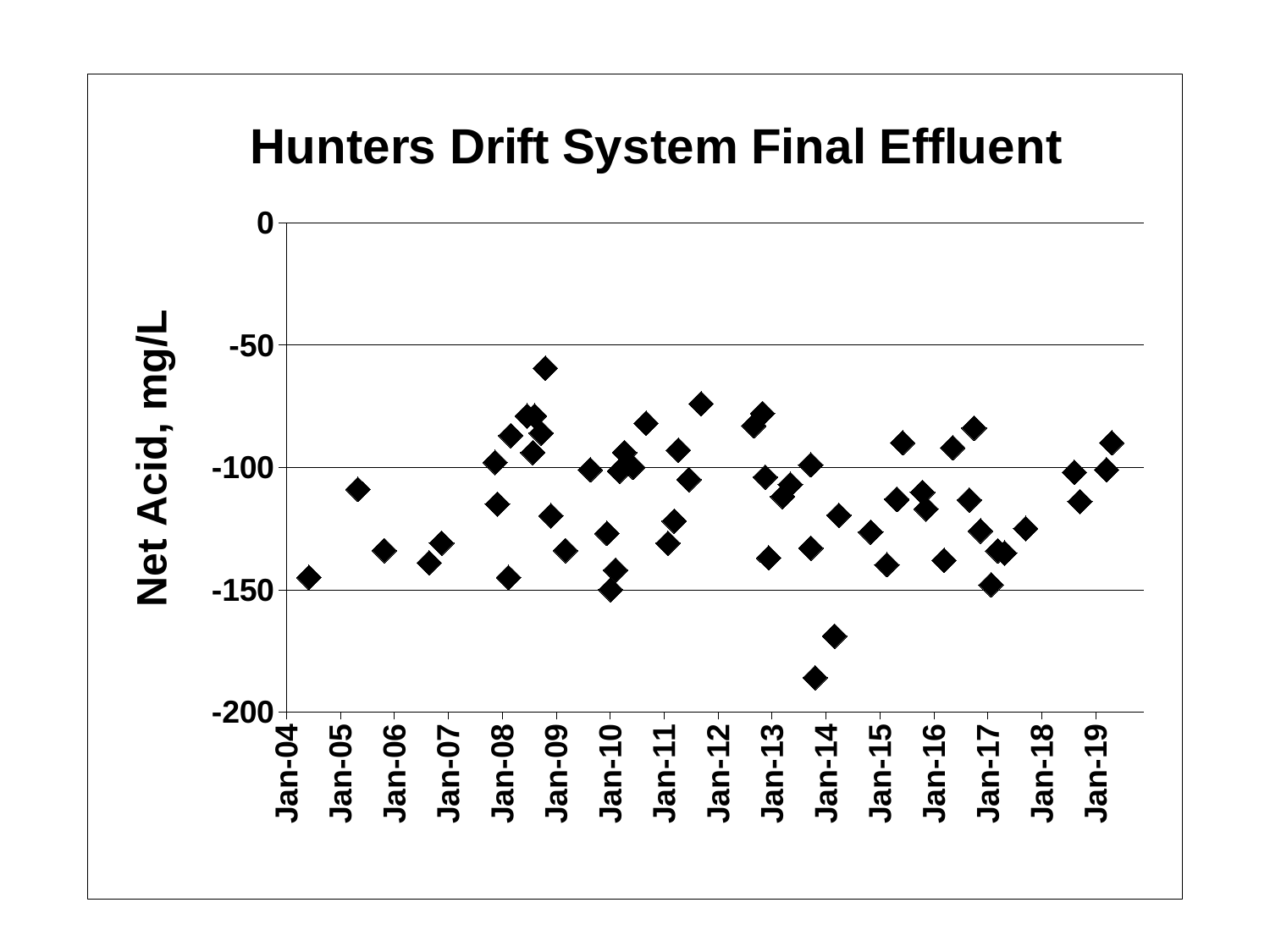
Is the point plotted near Jan-06 greater or less than -100? less Is the highest plotted point on the chart greater or less than -100? greater How many year labels are shown on the horizontal axis of the chart? 16 Is the lowest plotted point on the chart greater or less than -200? greater What is the label on the vertical axis of the chart? Net Acid, mg/L What is the title of the chart? Hunters Drift System Final Effluent What kind of chart is shown on the slide? Scatter chart